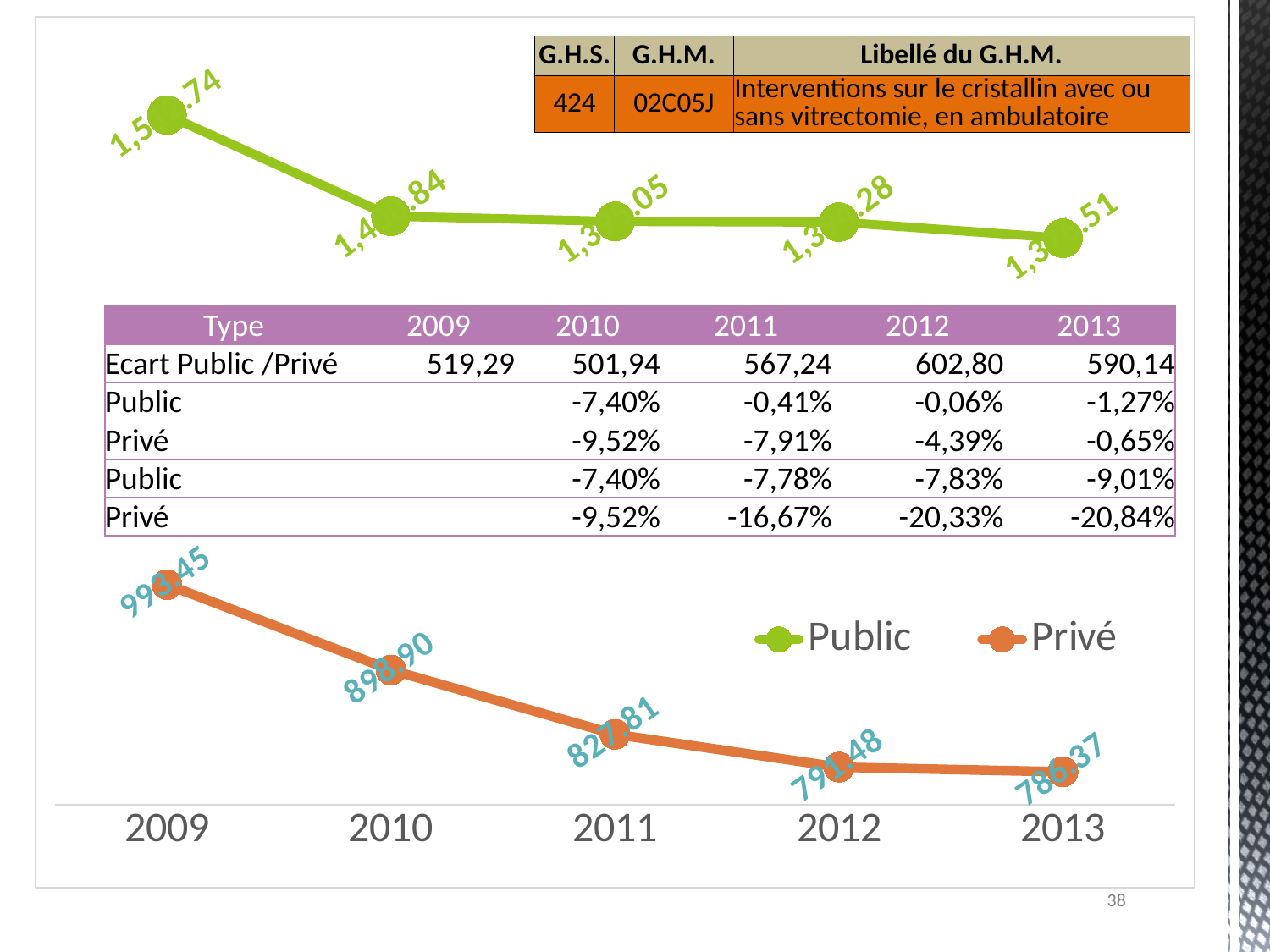
What kind of chart is shown on the slide? Line chart Which years are shown on the x axis of the chart? 2009, 2010, 2011, 2012, 2013 In which year is the Public series at its highest? 2009 In 2009, which series has the higher value, Public or Privé? Public In 2013, which series has the lower value, Public or Privé? Privé What are the two series named in the chart's legend? Public and Privé Which colour is used for the Privé series in the chart? Orange In which year is the Privé series at its highest? 2009 How many series does the chart's legend list? 2 Does the Public series rise or fall from 2009 to 2013? Fall Does the Privé series rise or fall from 2009 to 2013? Fall How many years are plotted along the x axis of the chart? 5